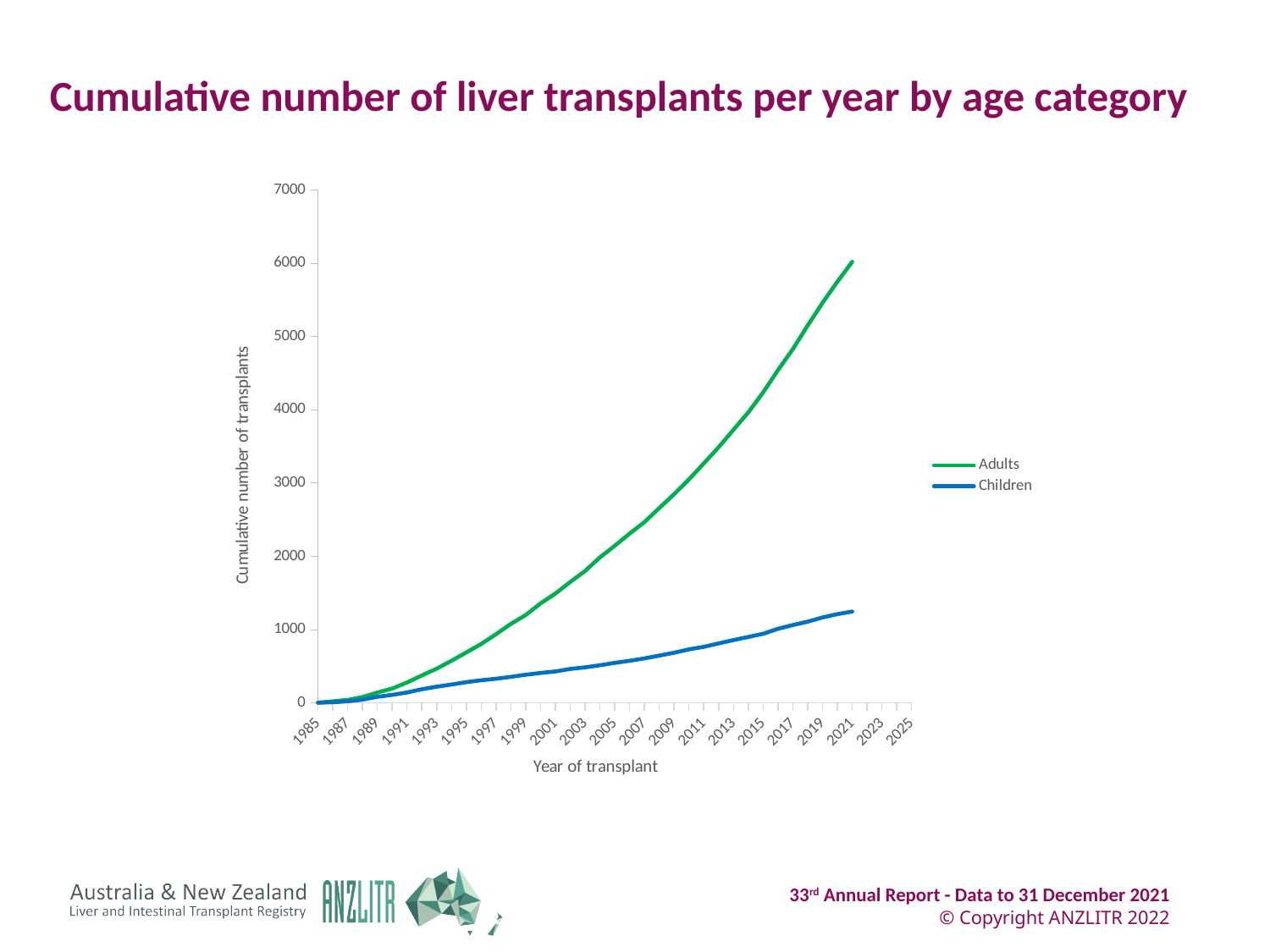
Do the values for Children rise or fall from 1985 to 2021? rise Is the value for Children in 2021 greater or less than 1000? greater How many series does the legend list? 2 What kind of chart is shown on the slide? line chart Do the values for Adults rise or fall from 1985 to 2021? rise Is the value for Children in 2001 greater or less than 1000? less Is the value for Adults in 2021 greater or less than 5000? greater What colour is the line for the Children series? blue What is the title of the chart? Cumulative number of liver transplants per year by age category Which series has the higher cumulative number of transplants in 2021, Adults or Children? Adults